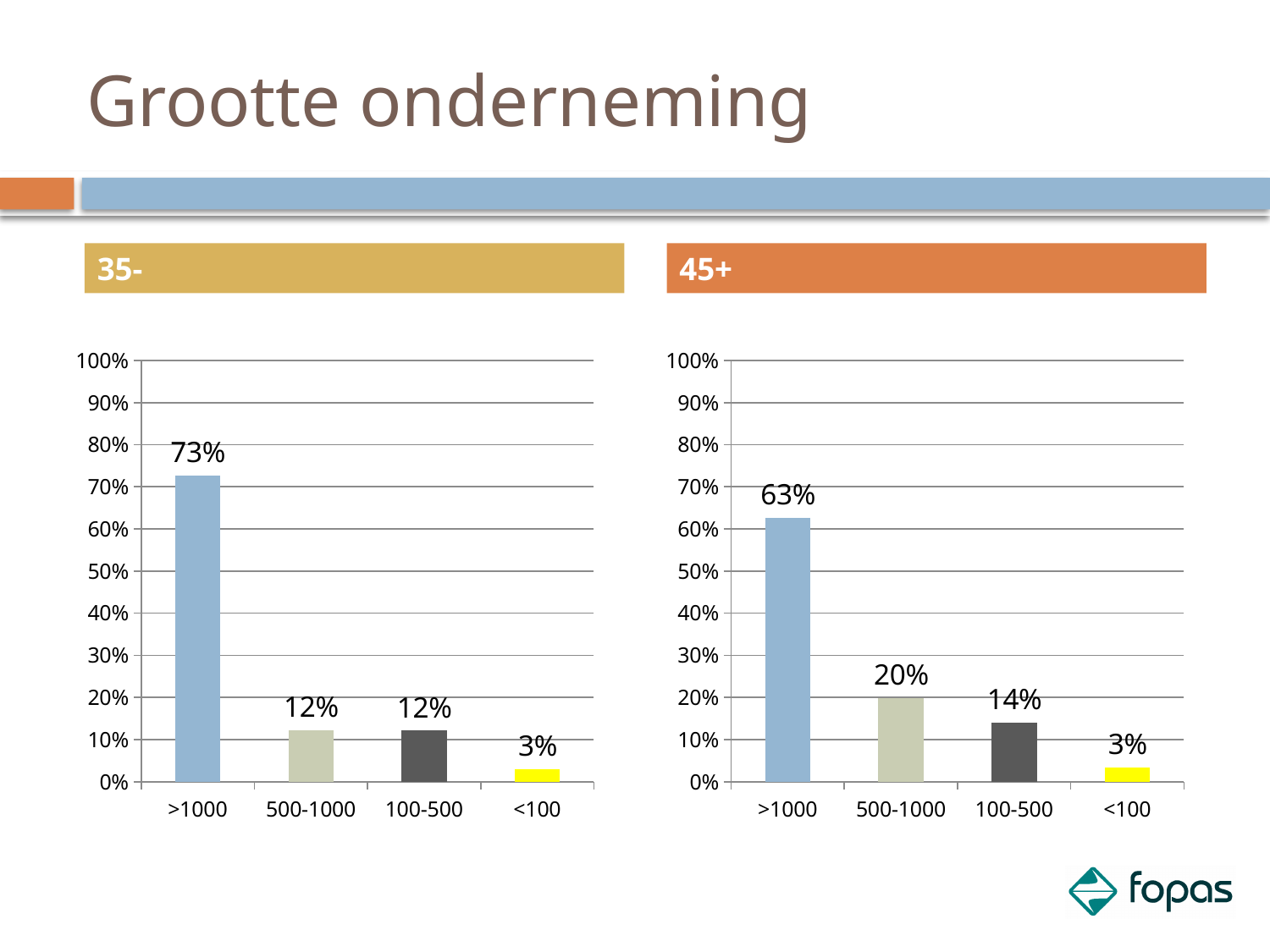
In the 35- chart, which category has the highest value? >1000 In the 45+ chart, what is the difference between the 500-1000 and 100-500 values? 6% In the 45+ chart, what is the value for 500-1000? 20% In the 35- chart, is the value for >1000 greater or less than 70%? greater What kind of chart is the 35- chart? bar chart How many categories are shown in the 45+ chart? 4 In the 35- chart, what is the value for >1000? 73% What is the difference between the >1000 values in the 35- chart and the 45+ chart? 10% In the 45+ chart, do the values rise or fall from left to right along the x axis? fall Which is larger: the 500-1000 value in the 35- chart or the 500-1000 value in the 45+ chart? 45+ chart In the 45+ chart, what is the value for 100-500? 14% In the 45+ chart, which category has the lowest value? <100